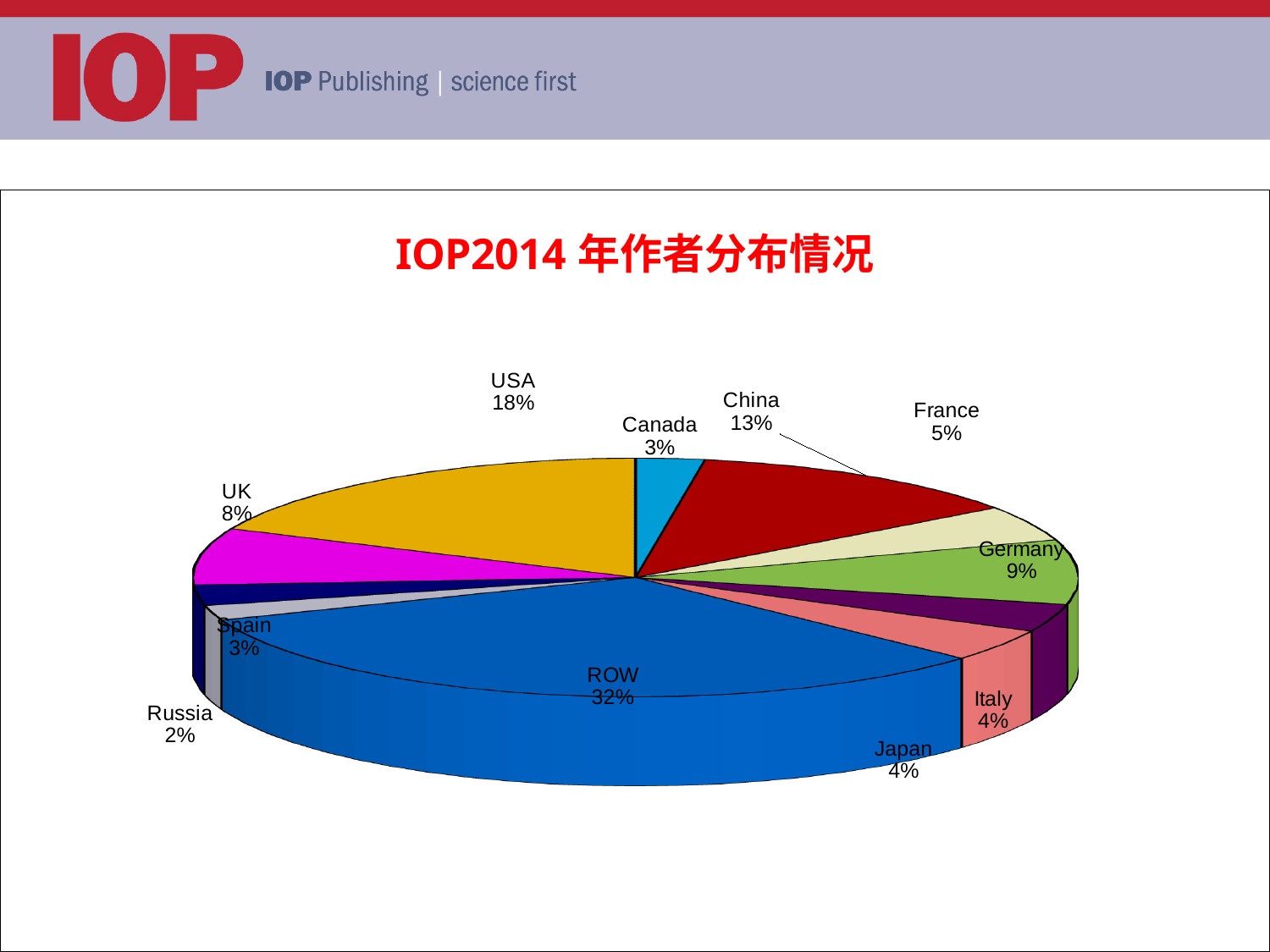
Which labelled slice has the smallest share? Russia What share of the pie does ROW account for? 32% Which is larger, the share for France or the share for Germany? Germany What is the difference between the USA share and the China share? 5% What kind of chart is shown on the slide? pie chart What is the combined share of Japan and Italy? 8% What is the value shown for Germany? 9% What is the value shown for USA? 18% What is the value shown for UK? 8% Which labelled slice has the largest share? ROW What is the title of the chart? IOP2014 年作者分布情况 What is the value shown for China? 13%